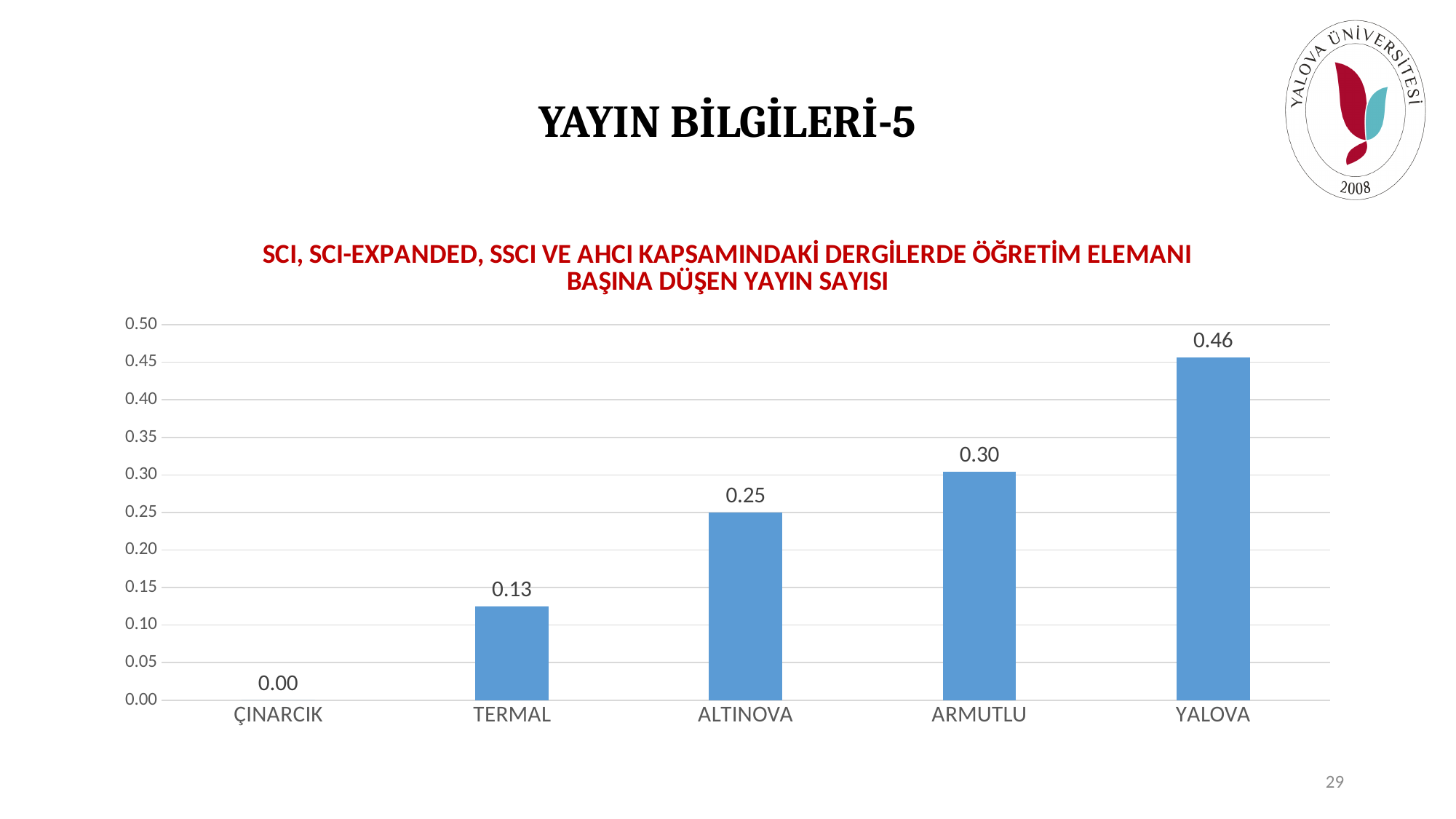
What is the difference between the values for YALOVA and ARMUTLU? 0.16 Is the value for ARMUTLU greater or less than 0.20? greater Do the values rise or fall from left to right along the x axis? rise What is the value for ÇINARCIK? 0.00 Which category has the highest value? YALOVA What is the value for TERMAL? 0.13 How many categories are shown on the x axis? 5 Which is larger, the value for ALTINOVA or the value for TERMAL? ALTINOVA What is the value for YALOVA? 0.46 What kind of chart is shown on the slide? bar chart What is the value for ALTINOVA? 0.25 Which category has the lowest value? ÇINARCIK